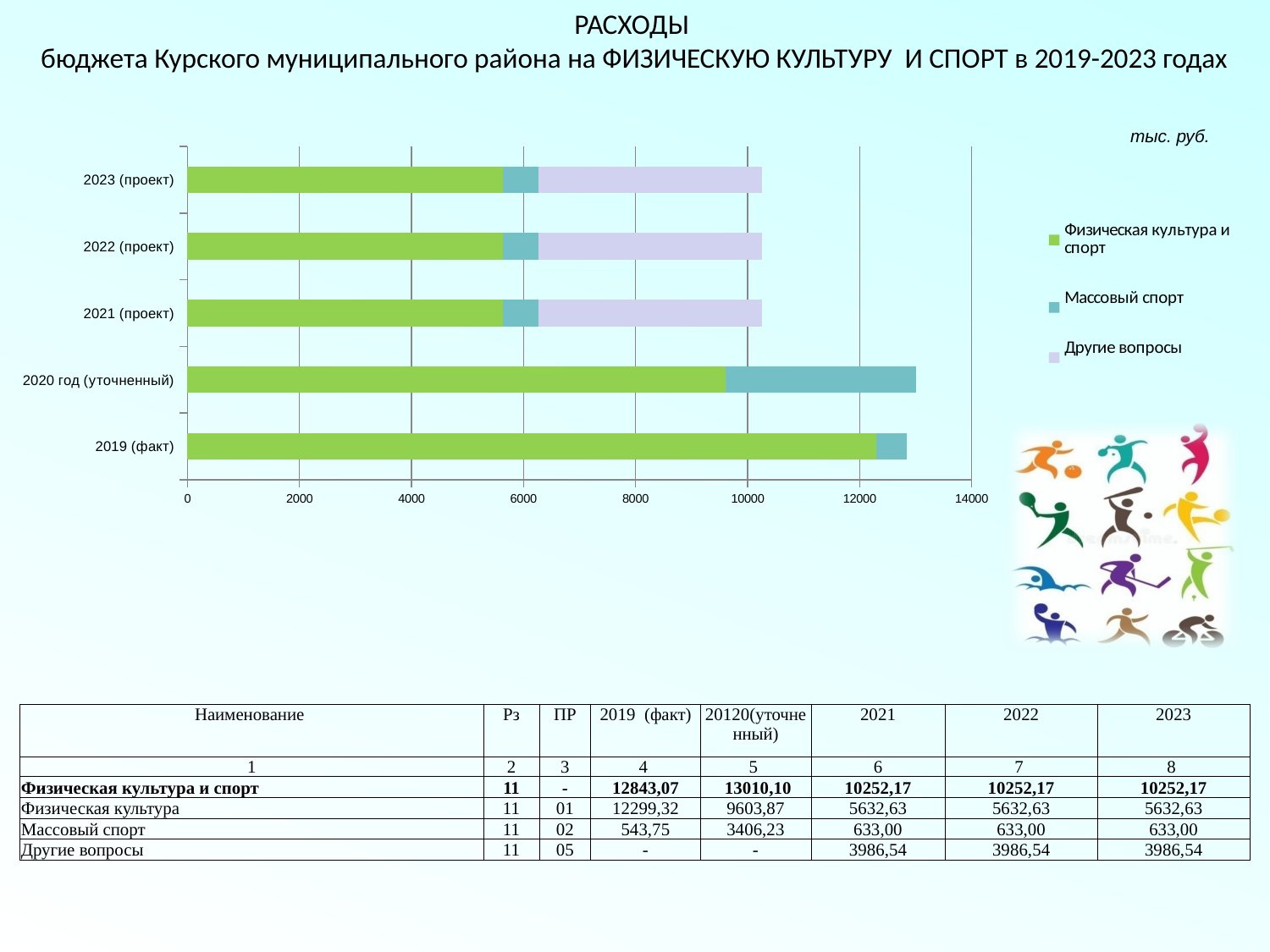
How does the Физическая культура и спорт segment change from 2021 (проект) to 2023 (проект)? It stays the same How many series does the chart legend list? 3 What are the three series named in the chart legend? Физическая культура и спорт, Массовый спорт, Другие вопросы What kind of chart is shown on the slide? Stacked bar chart Using the table values, what is the difference between Массовый спорт in 2020 (уточненный) and in 2019 (факт)? 2862,48 How many year categories are plotted on the chart? 5 Is the Физическая культура и спорт segment for 2021 (проект) greater or less than 6000? less According to the table, what is the total for Физическая культура и спорт in 2021? 10252,17 Which year has the largest Массовый спорт segment on the chart? 2020 год (уточненный) According to the table, what is the value of Физическая культура for 2019 (факт)? 12299,32 Which is larger, the Физическая культура и спорт segment for 2019 (факт) or for 2020 год (уточненный)? 2019 (факт) Is the total bar length for 2019 (факт) greater or less than 12000? greater